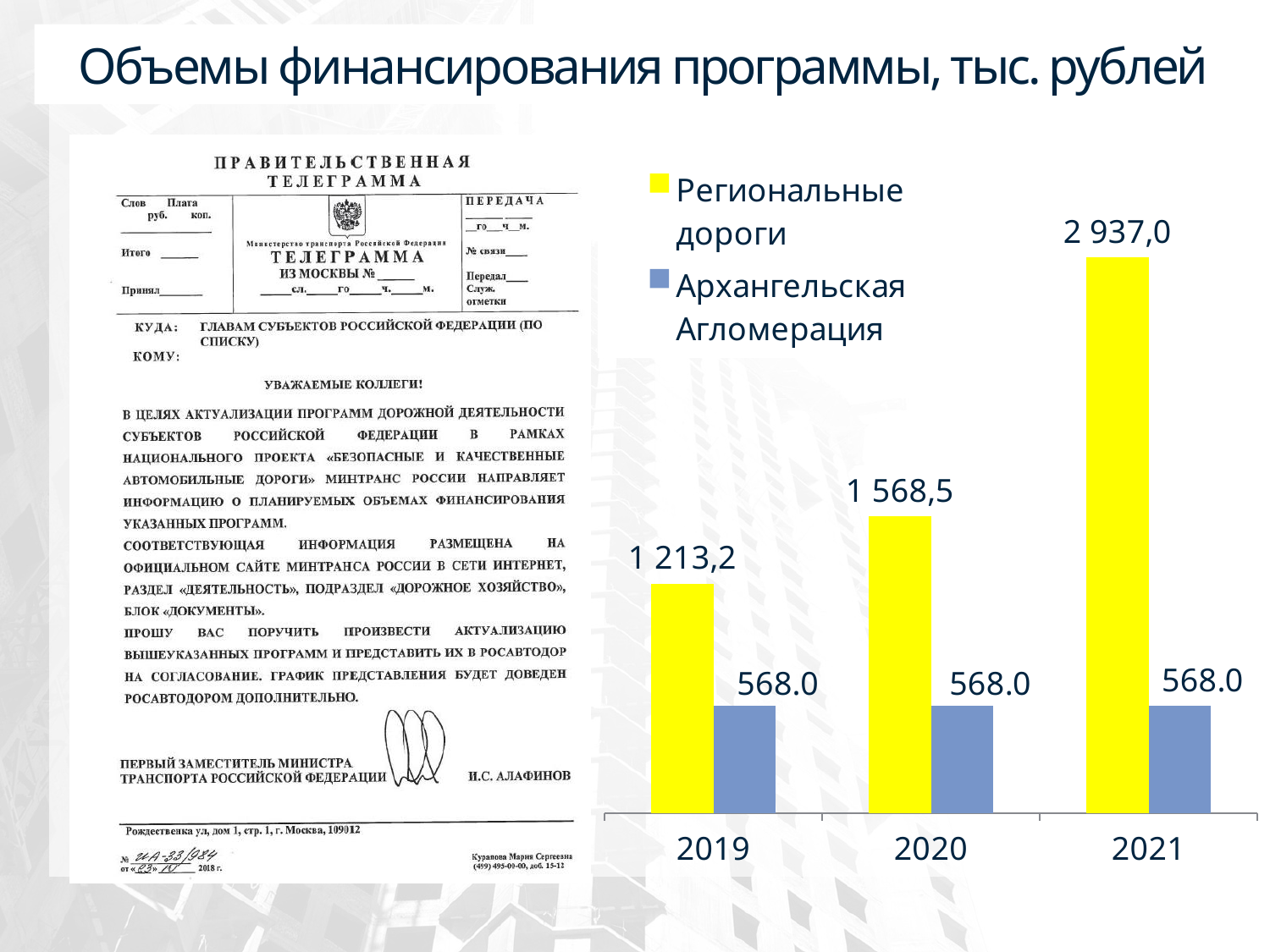
Do the values for Региональные дороги rise or fall from 2019 to 2021? Rise What kind of chart is shown on the slide? Bar chart How many series does the legend list? 2 What is the difference between the Региональные дороги values for 2021 and 2019? 1 723,8 What is the value for Архангельская Агломерация in 2020? 568.0 What is the value for Региональные дороги in 2019? 1 213,2 What is the value for Региональные дороги in 2021? 2 937,0 In which year is the value for Региональные дороги lowest? 2019 What is the difference between the Региональные дороги values for 2020 and 2019? 355,3 In which year is the value for Региональные дороги highest? 2021 How many years are shown on the x axis? 3 Which is larger in 2020: Региональные дороги or Архангельская Агломерация? Региональные дороги